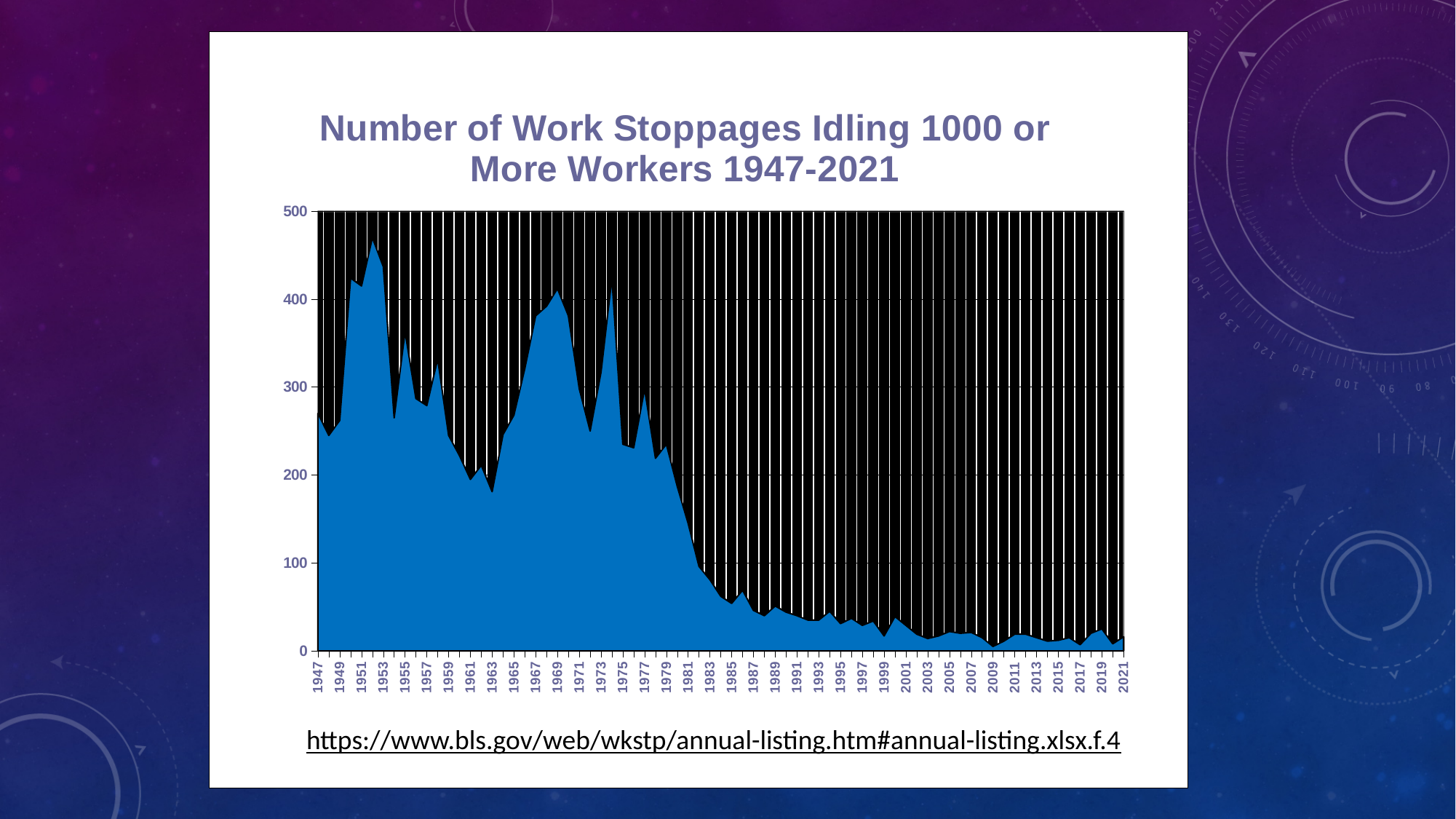
In which year does the number of work stoppages reach its highest point? 1952 Which year has the larger value, 1981 or 1985? 1981 What colour is the filled area in the chart? Blue Is the value for 1947 greater or less than 200? greater Is the value for 1985 greater or less than 100? less What is the title of the chart? Number of Work Stoppages Idling 1000 or More Workers 1947-2021 Which year has the larger value, 1952 or 1969? 1952 Overall, do the values rise or fall from 1947 to 2021? Fall What kind of chart is shown on the slide? Area chart Is the value for 1952 greater or less than 400? greater